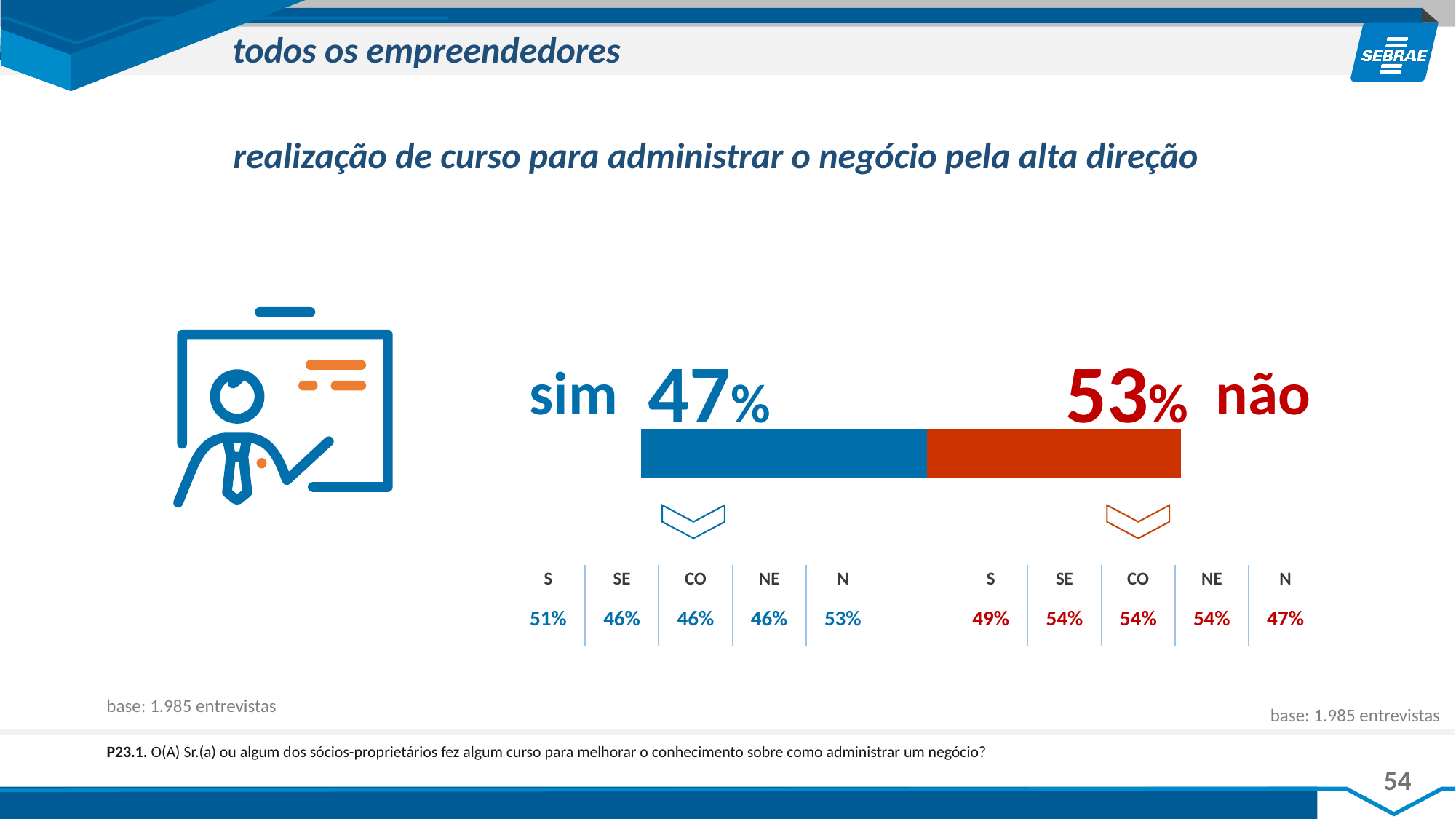
What is the total of the two segments of the stacked bar? 100% In the regional breakdown for "sim", which region has the highest value? N What is the difference between the "não" share and the "sim" share in the bar? 6 percentage points How many regions are listed in the breakdown under "sim"? 5 What kind of chart is shown on the slide? Bar chart What percentage of respondents answered "sim" in the bar chart? 47% What percentage of respondents answered "não" in the bar chart? 53% Which answer has the larger share in the bar, "sim" or "não"? não In the regional breakdown for "não", which region has the lowest value? N In the regional breakdown for "não", what is the value for region S? 49% In the regional breakdown for "sim", what is the value for region N? 53% What colour is the "não" segment of the bar? Red